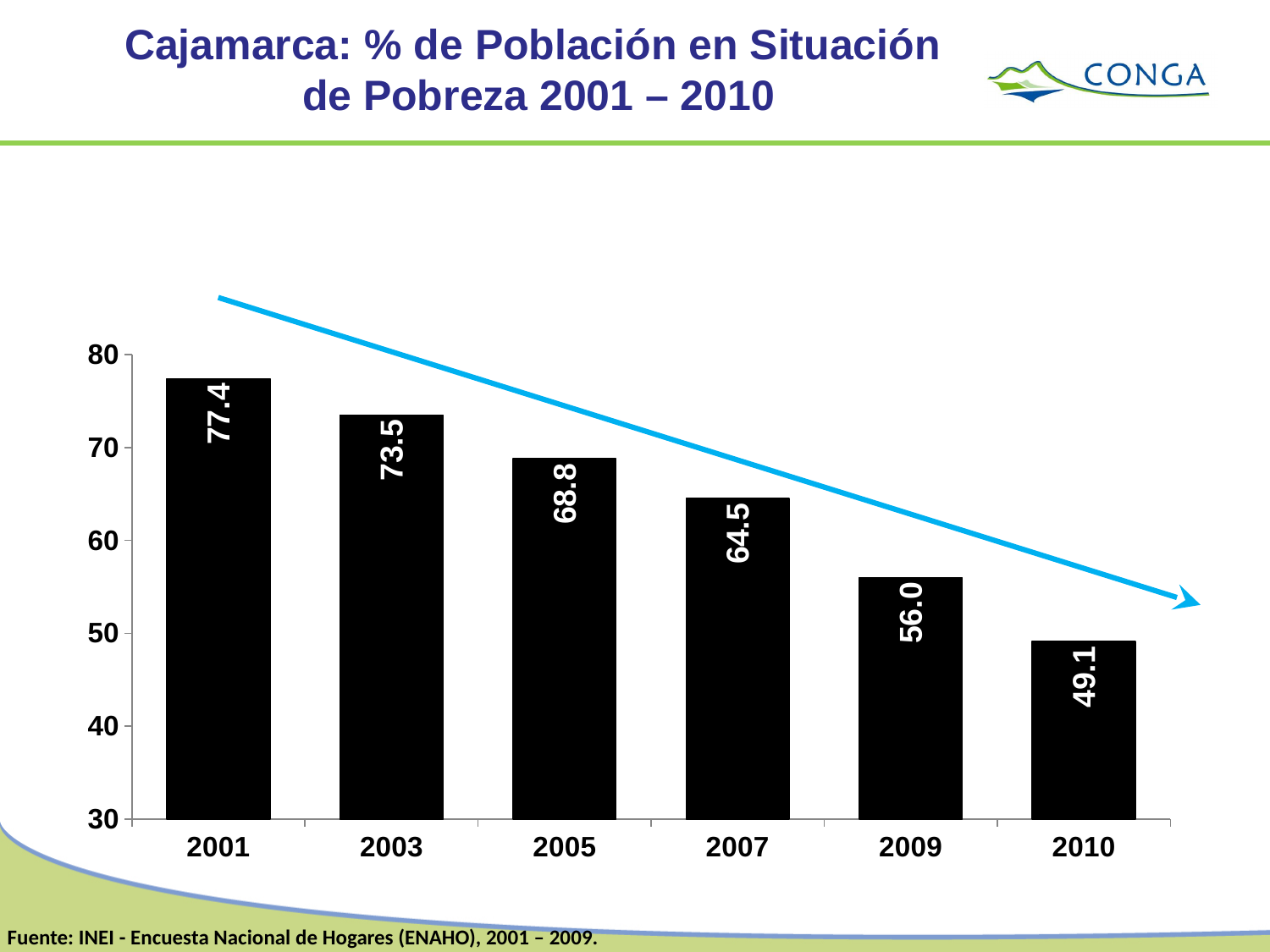
Is the value for 2009 greater or less than 60? less Do the values rise or fall from 2001 to 2010? fall What kind of chart is shown? bar chart How many years are shown on the x axis? 6 What is the value for 2010? 49.1 What is the difference between the values for 2005 and 2009? 12.8 Which year has the lowest value? 2010 Which is larger, the value for 2003 or the value for 2009? 2003 What is the value for 2007? 64.5 What is the difference between the values for 2001 and 2010? 28.3 Which year has the highest value? 2001 What is the value for 2001? 77.4